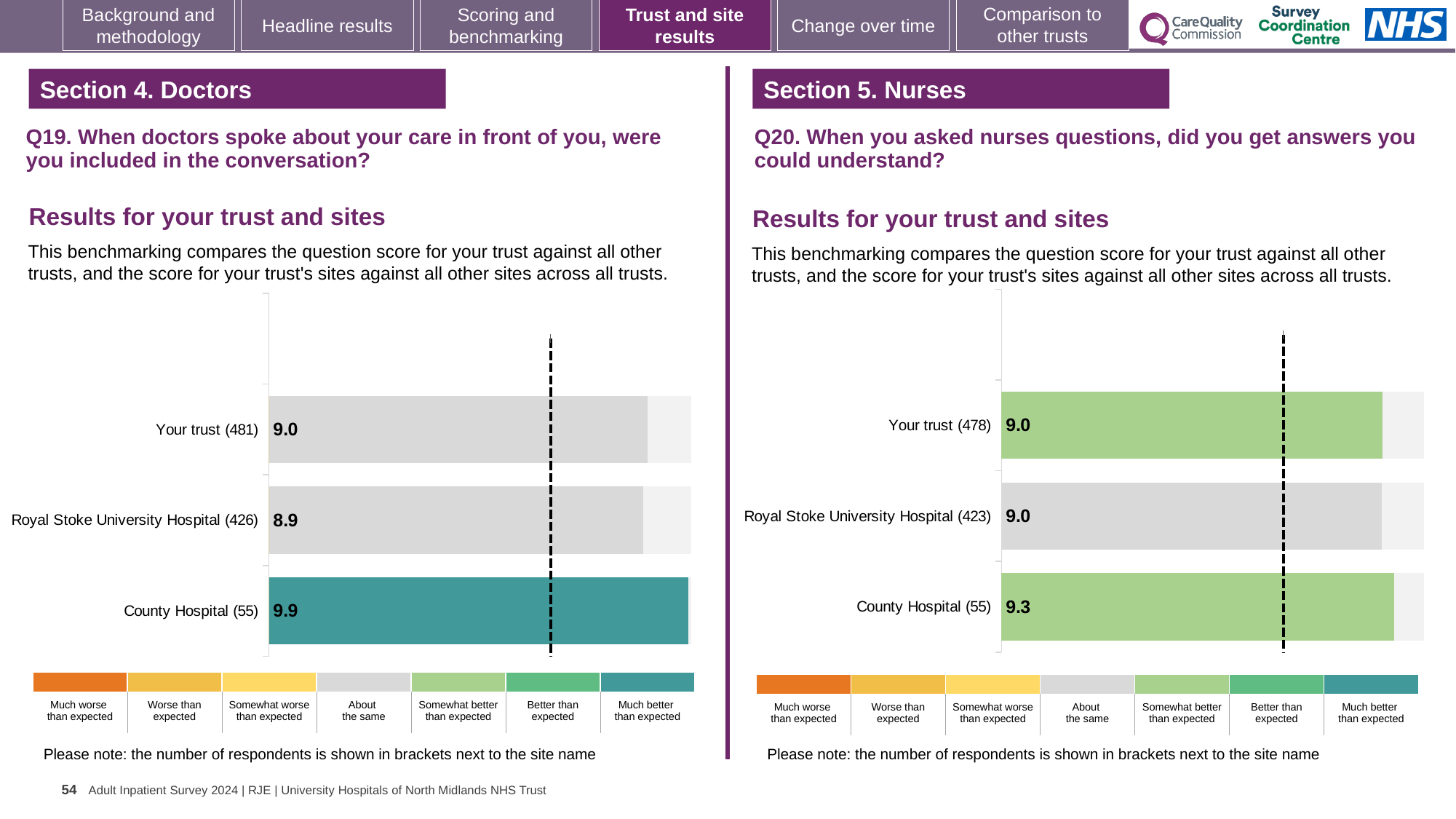
In the Q20 chart on the right, what is the difference between the County Hospital score and the Your trust score? 0.3 In the Q19 chart on the left, what is the score for County Hospital? 9.9 In the Q19 chart on the left, which site or trust has the lowest score? Royal Stoke University Hospital In the Q20 chart on the right, what is the score for Your trust? 9.0 In the Q19 chart on the left, what is the score for Royal Stoke University Hospital? 8.9 In the Q19 chart on the left, what is the difference between the County Hospital score and the Royal Stoke University Hospital score? 1.0 In the Q19 chart on the left, how many bars are plotted? 3 In the Q20 chart on the right, what is the score for County Hospital? 9.3 In the Q19 chart on the left, which site or trust has the highest score? County Hospital In the Q20 chart on the right, which site or trust has the highest score? County Hospital In the Q19 chart on the left, how many respondents are shown in brackets for County Hospital? 55 What type of chart is used for the Q20 results on the right? Bar chart